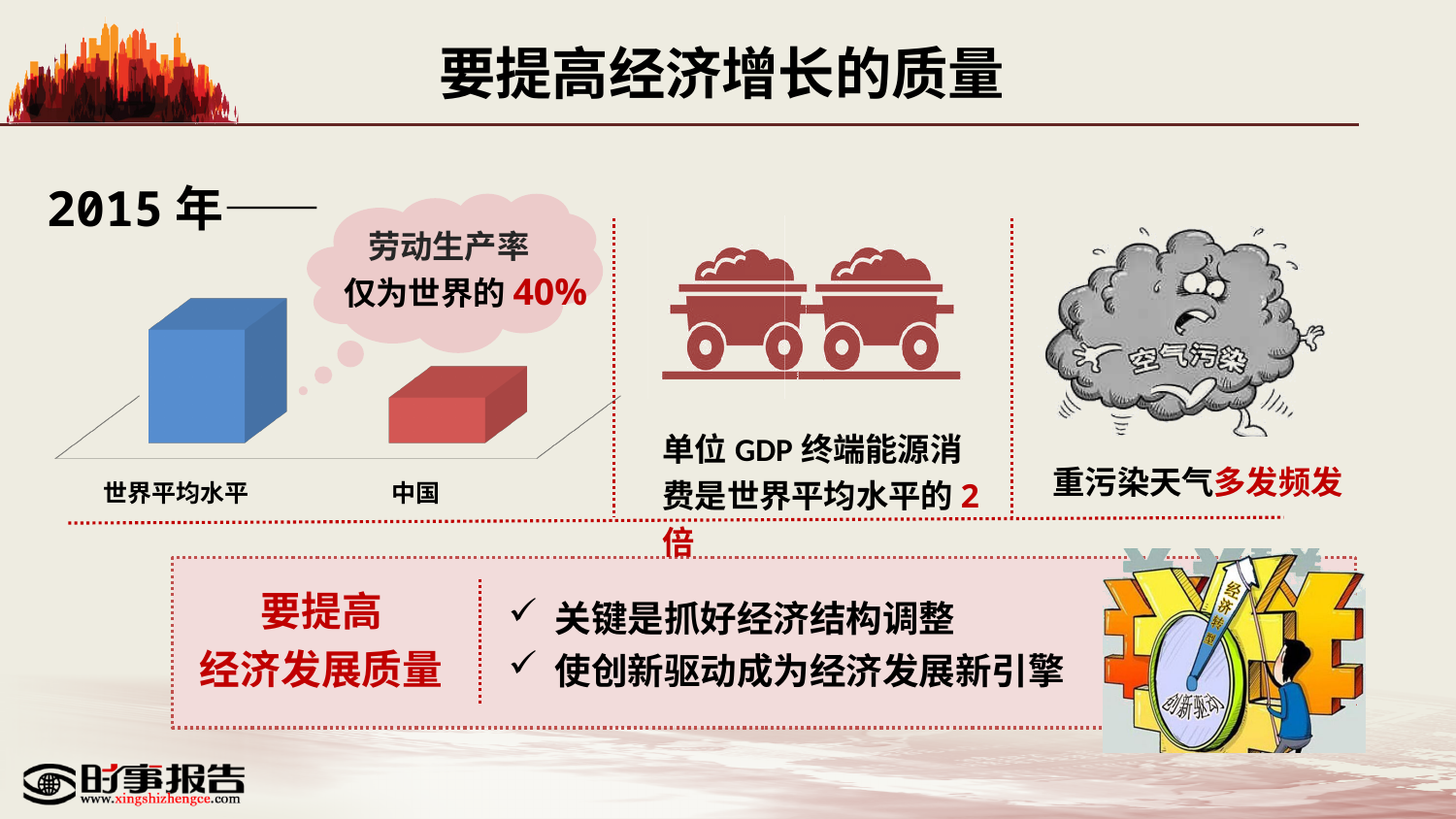
According to the callout next to the bar chart, China's labour productivity (劳动生产率) is what percentage of the world's? 40% How many categories does the bar chart on the left of the slide show? 2 In the bar chart on the left, what colour is the bar for 中国? red In the bar chart on the left, what are the two category labels shown under the bars? 世界平均水平 and 中国 What kind of chart is shown on the left of the slide comparing 世界平均水平 and 中国? bar chart In the bar chart on the left, which category has the taller bar? 世界平均水平 In the bar chart on the left, which category has the shorter bar? 中国 In the bar chart on the left, is the bar for 中国 taller or shorter than the bar for 世界平均水平? shorter